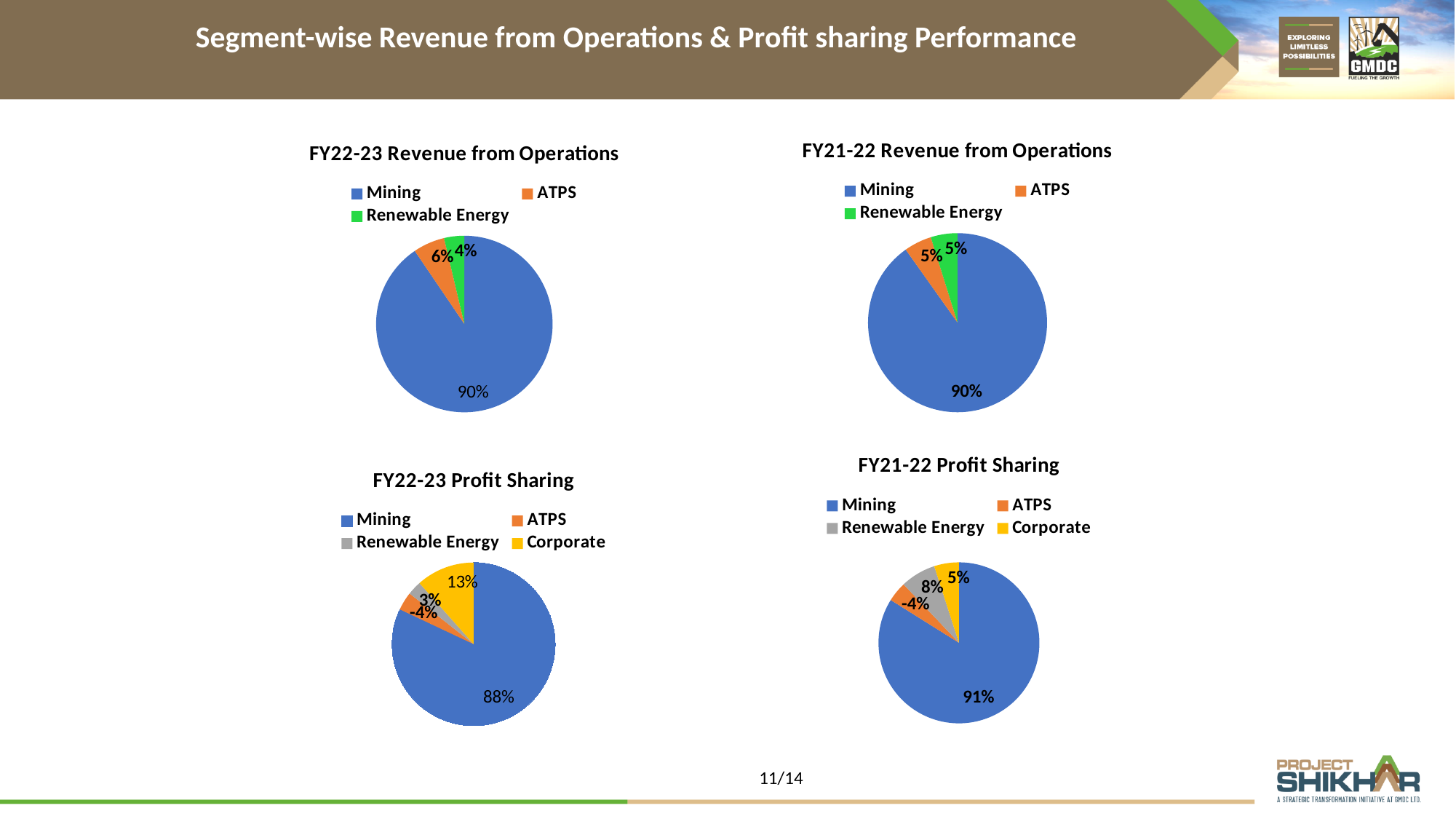
In the FY22-23 Revenue from Operations chart, what is the difference between the ATPS and Renewable Energy shares? 2% In the FY21-22 Profit Sharing chart, which segment has the largest share? Mining How many segments does the legend of the FY22-23 Profit Sharing chart list? 4 In the FY22-23 Profit Sharing chart, which segment has the lowest value? ATPS In the FY22-23 Profit Sharing chart, what is the value for Corporate? 13% In the FY21-22 Profit Sharing chart, which is larger, Renewable Energy or Corporate? Renewable Energy What type of chart is the FY21-22 Revenue from Operations chart? Pie chart In the FY21-22 Profit Sharing chart, what is the value for Renewable Energy? 8% In the FY22-23 Revenue from Operations chart, what is the share for ATPS? 6% In the FY22-23 Revenue from Operations chart, what share does Mining hold? 90% In the FY21-22 Revenue from Operations chart, what is the share for Renewable Energy? 5% In the FY22-23 Profit Sharing chart, what is the value for ATPS? -4%